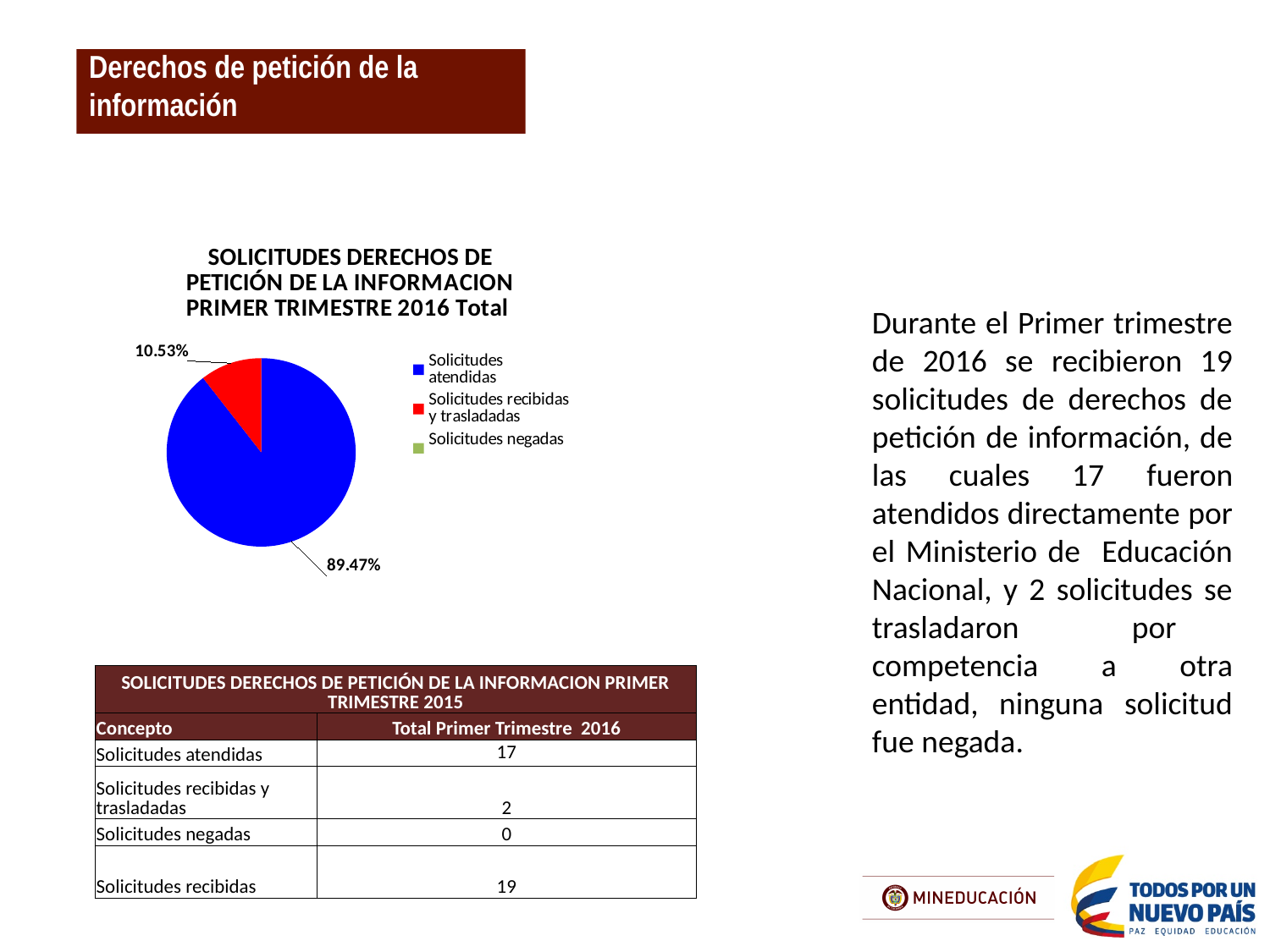
What colour is the slice for 'Solicitudes atendidas'? Blue Which is larger, the slice for 'Solicitudes atendidas' or the slice for 'Solicitudes recibidas y trasladadas'? Solicitudes atendidas Which category has the largest slice of the pie? Solicitudes atendidas How many entries does the legend of the pie chart list? 3 What is the title of the pie chart? SOLICITUDES DERECHOS DE PETICIÓN DE LA INFORMACION PRIMER TRIMESTRE 2016 Total What is the difference in percentage points between the 'Solicitudes atendidas' slice and the 'Solicitudes recibidas y trasladadas' slice? 78.94% What share of the pie does 'Solicitudes recibidas y trasladadas' represent? 10.53% How many percentage labels are printed on the pie chart? 2 What share of the pie does 'Solicitudes atendidas' represent? 89.47% What kind of chart is shown on the slide? Pie chart